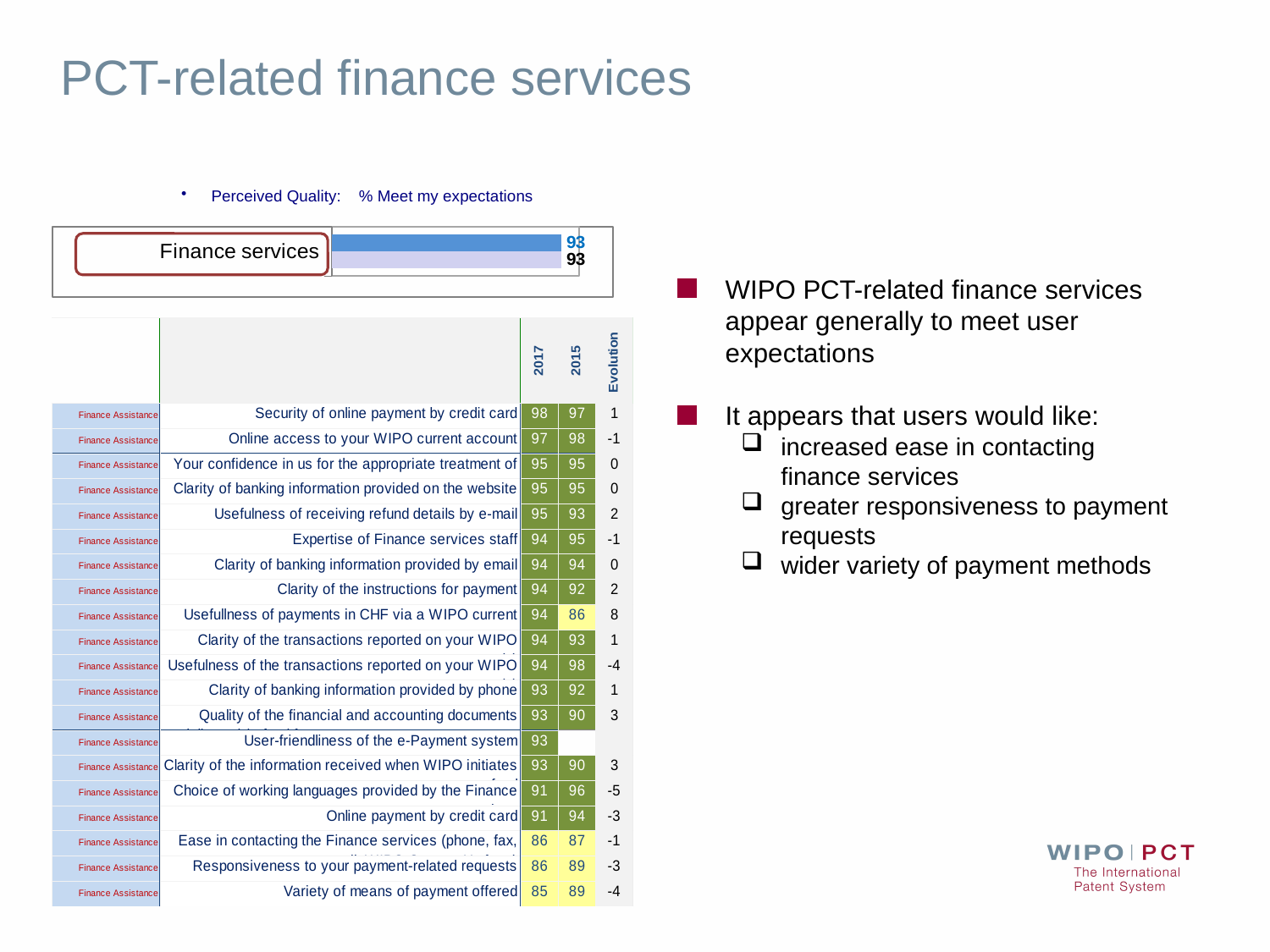
What is the category label shown next to the bars in the bar chart at the top left? Finance services How many bars are plotted in the 'Finance services' bar chart? 2 In the table below the bar chart, what is the 2017 value for 'Security of online payment by credit card'? 98 In the 'Finance services' bar chart, what value is shown on the bottom (lighter blue) bar? 93 What type of chart is the 'Finance services' chart at the top left of the slide? bar chart In the 'Finance services' bar chart, what value is shown on the top (darker blue) bar? 93 What measure does the bullet above the 'Finance services' bar chart say is being shown? Perceived Quality: % Meet my expectations In the 'Finance services' bar chart, what is the difference between the two bar values? 0 In the table below the bar chart, which item has the highest 2017 value? Security of online payment by credit card In the table below the bar chart, what is the 2015 value for 'Usefullness of payments in CHF via a WIPO current'? 86 In the table below the bar chart, which item has the lowest 2017 value? Variety of means of payment offered In the table below the bar chart, what is the Evolution value for 'Choice of working languages provided by the Finance'? -5